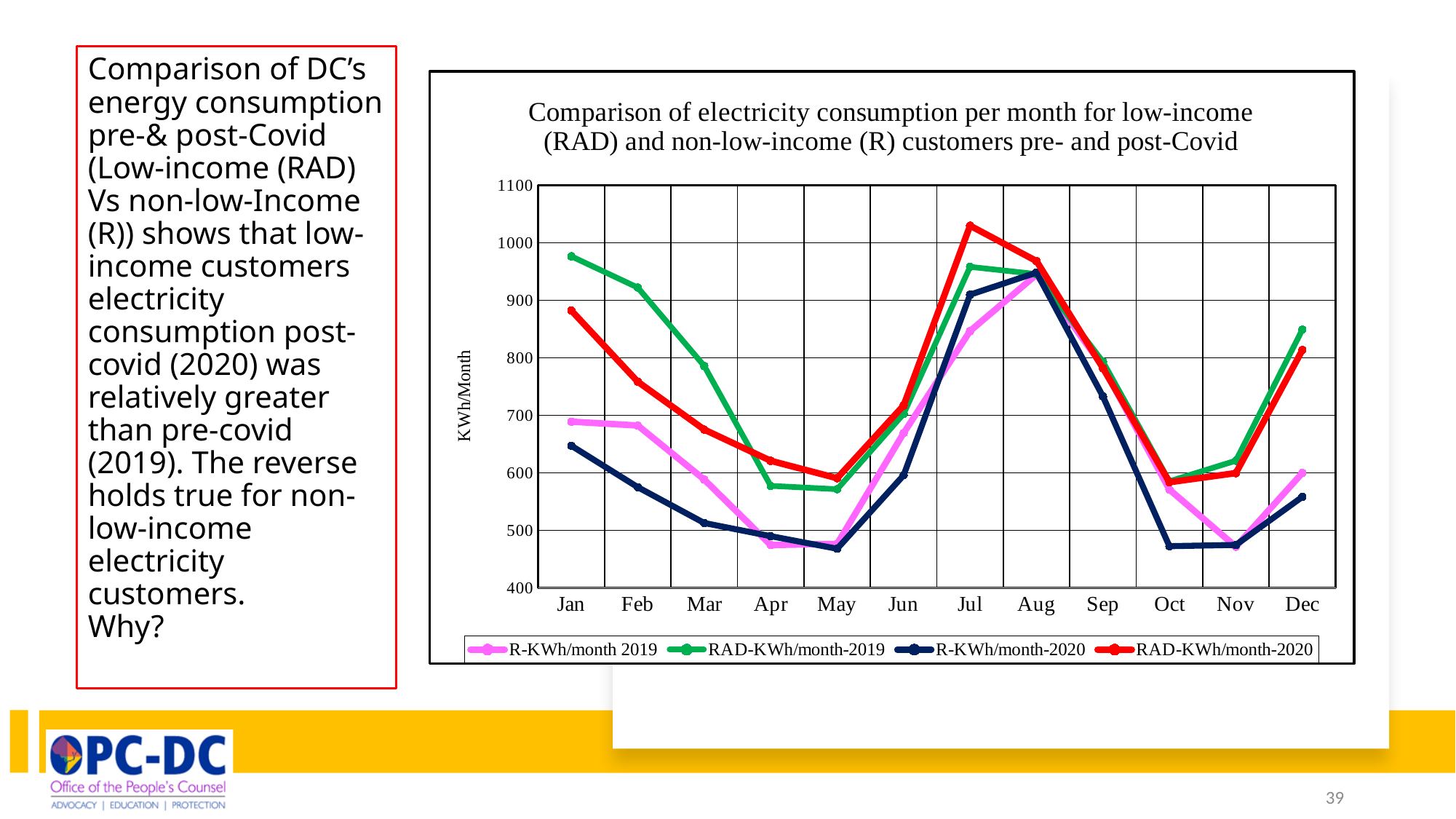
Is the value for R-KWh/month 2019 in Jan greater or less than 600? greater In which month is R-KWh/month 2019 at its highest? Aug From Jan to May, does RAD-KWh/month-2019 rise or fall? fall How many months are plotted along the x axis? 12 What is the label on the y axis of the chart? KWh/Month Is the value for R-KWh/month-2020 in Oct greater or less than 500? less In Jan, which is higher: RAD-KWh/month-2019 or RAD-KWh/month-2020? RAD-KWh/month-2019 How many series does the legend list? 4 Is the value for RAD-KWh/month-2020 in Jul greater or less than 1000? greater What kind of chart is shown on the slide? line chart In which month is RAD-KWh/month-2020 at its highest? Jul